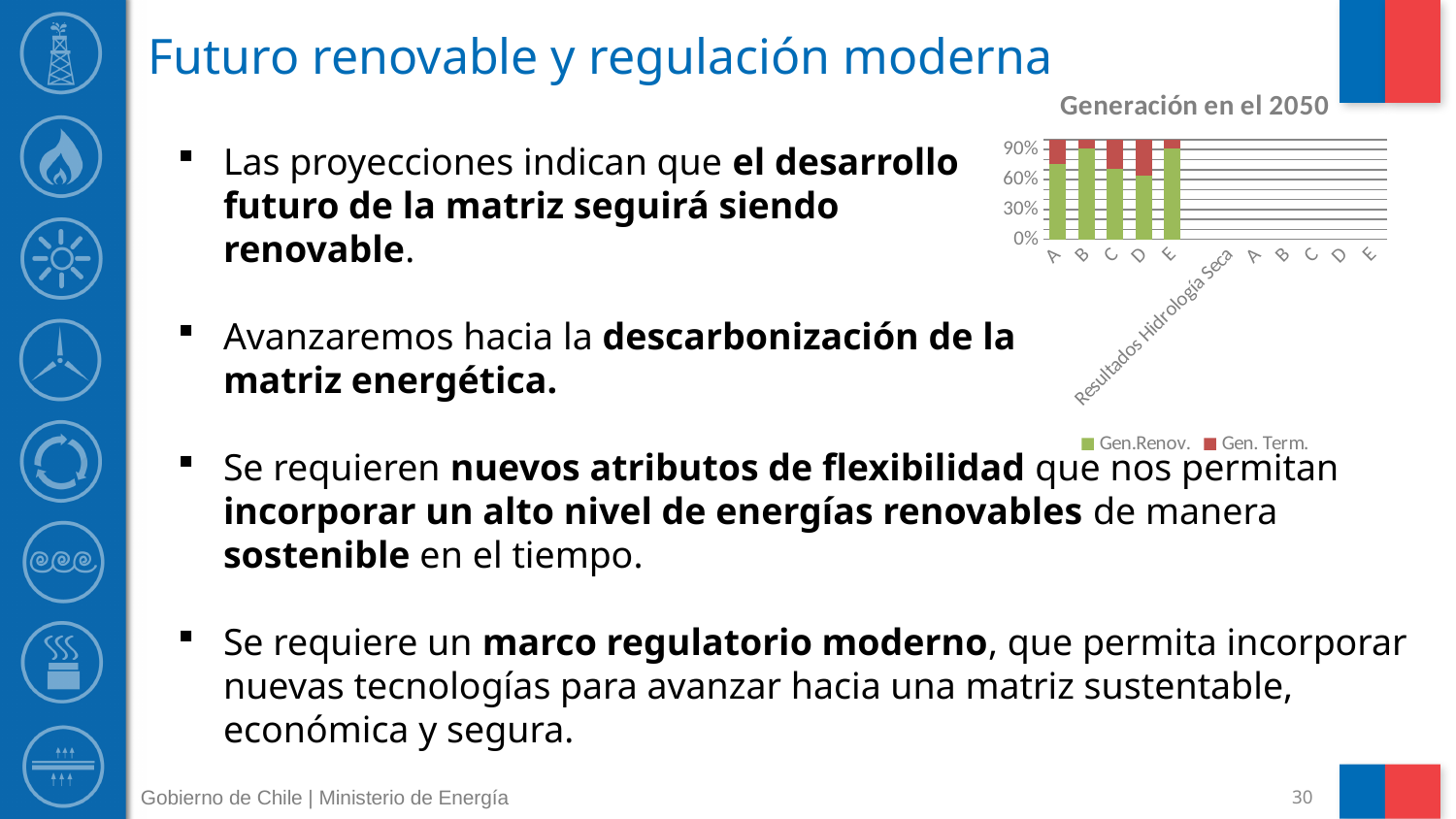
What is the highest percentage tick shown on the chart's vertical axis? 90% Which series makes up the larger part of each bar in the Resultados Hidrología Seca group, Gen.Renov. or Gen. Term.? Gen.Renov. Which two series are listed in the chart legend? Gen.Renov. and Gen. Term. Is the Gen.Renov. value for bar A in the Resultados Hidrología Seca group greater or less than 60%? greater How many series does the chart legend list? 2 What is the title of the chart? Generación en el 2050 What kind of chart is shown on the slide? stacked bar chart Is the Gen.Renov. value for bar D in the Resultados Hidrología Seca group greater or less than 30%? greater Is the Gen. Term. share for bar A in the Resultados Hidrología Seca group greater or less than 30%? less